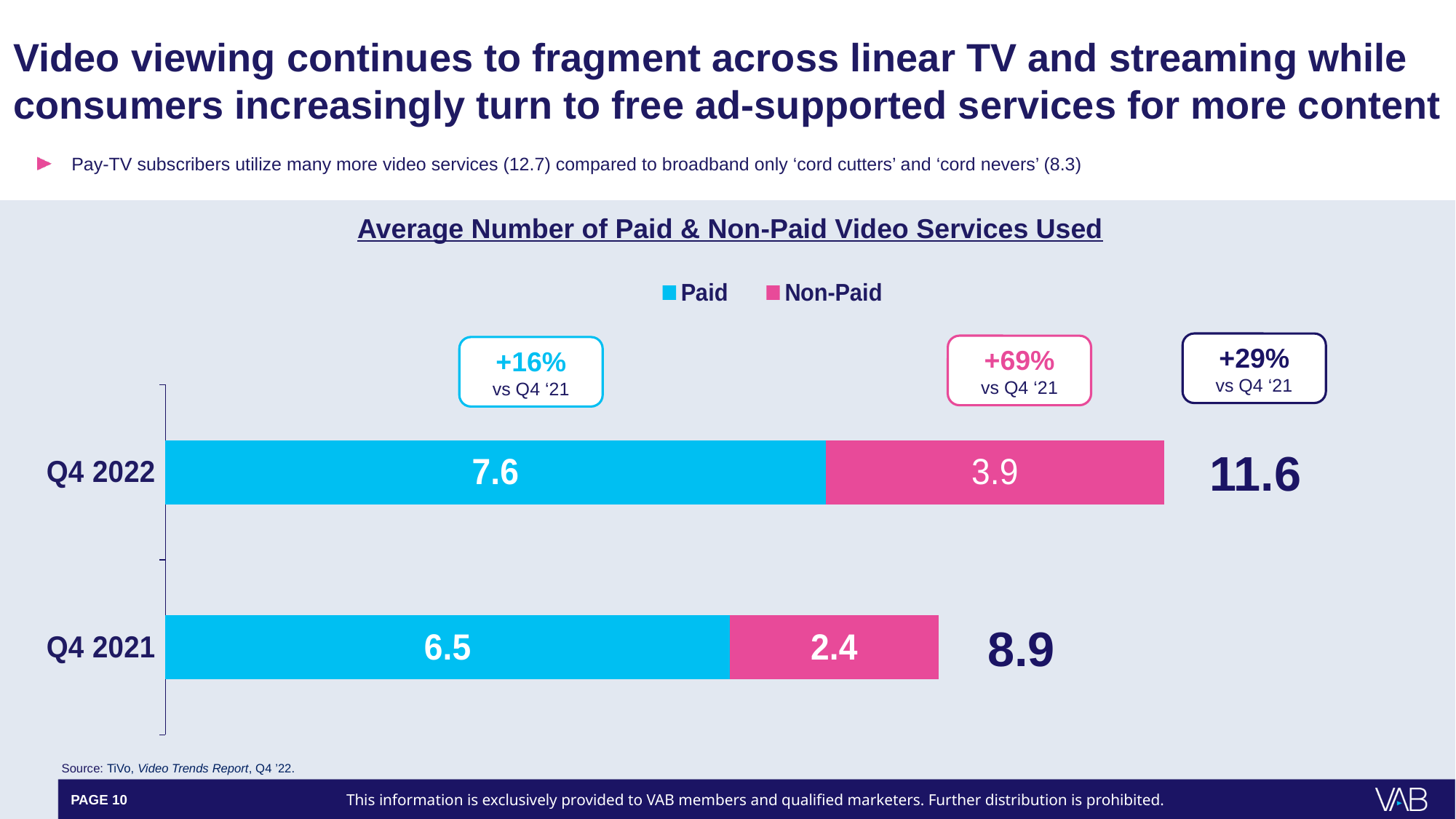
What is the Non-Paid value for Q4 2021? 2.4 What kind of chart is shown on the slide? Stacked bar chart How many series does the legend list? 2 What is the total of the stacked bar for Q4 2022? 11.6 What is the title of the chart? Average Number of Paid & Non-Paid Video Services Used What is the difference between the Paid values for Q4 2022 and Q4 2021? 1.1 What is the Non-Paid value for Q4 2022? 3.9 What is the total of the stacked bar for Q4 2021? 8.9 What is the Paid value for Q4 2022? 7.6 Which period has the higher total number of video services used? Q4 2022 What is the difference between the Non-Paid values for Q4 2022 and Q4 2021? 1.5 Which is larger, the Paid value for Q4 2021 or the Non-Paid value for Q4 2022? Paid value for Q4 2021